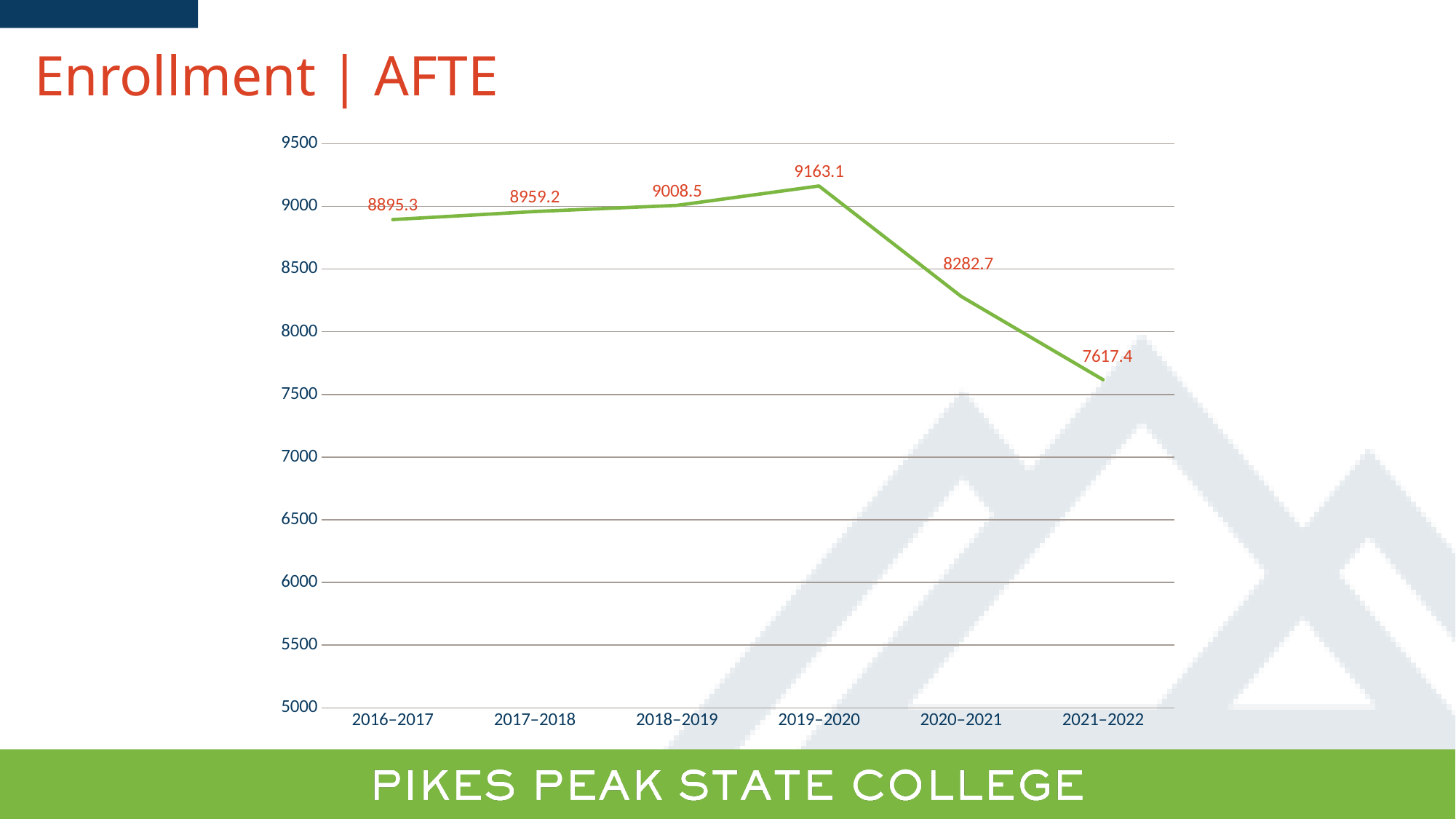
Which year has the highest AFTE value? 2019–2020 How many academic years are plotted on the chart? 6 What is the AFTE value for 2016–2017? 8895.3 What kind of chart is shown on the slide? line chart What is the AFTE value for 2020–2021? 8282.7 Is the AFTE value for 2020–2021 greater or less than 8500? less Which is larger, the AFTE value for 2017–2018 or for 2018–2019? 2018–2019 What is the AFTE value for 2021–2022? 7617.4 What is the difference between the AFTE values for 2019–2020 and 2021–2022? 1545.7 What is the AFTE value for 2019–2020? 9163.1 Which year has the lowest AFTE value? 2021–2022 Does the AFTE value rise or fall from 2019–2020 to 2021–2022? fall